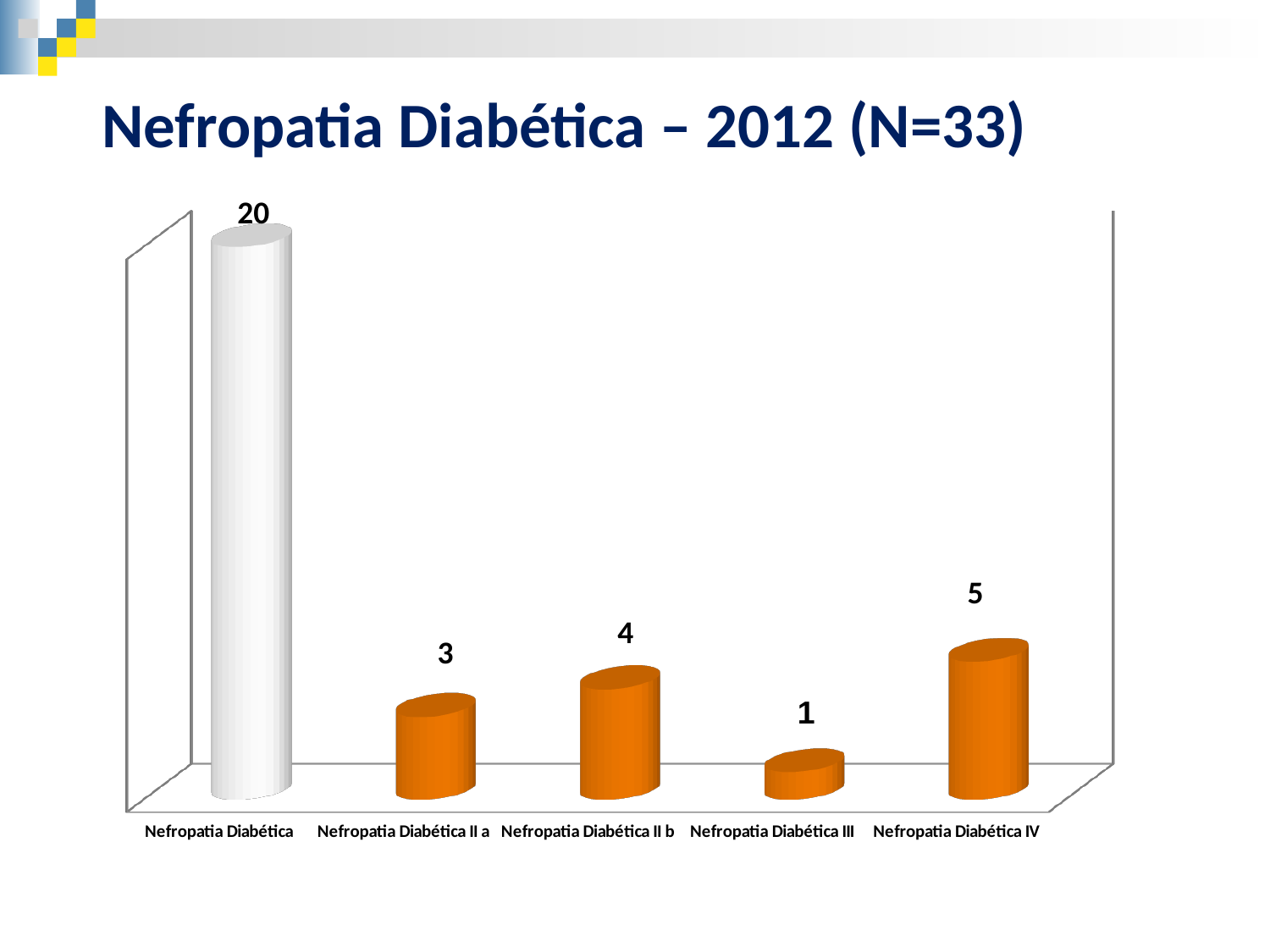
What is the value for Nefropatia Diabética II b? 4 Which is larger, the value for Nefropatia Diabética II b or Nefropatia Diabética IV? Nefropatia Diabética IV What is the difference between the values for Nefropatia Diabética and Nefropatia Diabética IV? 15 What is the value for Nefropatia Diabética IV? 5 How many categories are shown in the chart? 5 What is the title of the slide? Nefropatia Diabética – 2012 (N=33) What kind of chart is shown on the slide? Bar chart What is the value for Nefropatia Diabética II a? 3 What is the value for Nefropatia Diabética? 20 What is the value for Nefropatia Diabética III? 1 Which category has the highest value? Nefropatia Diabética Which category has the lowest value? Nefropatia Diabética III